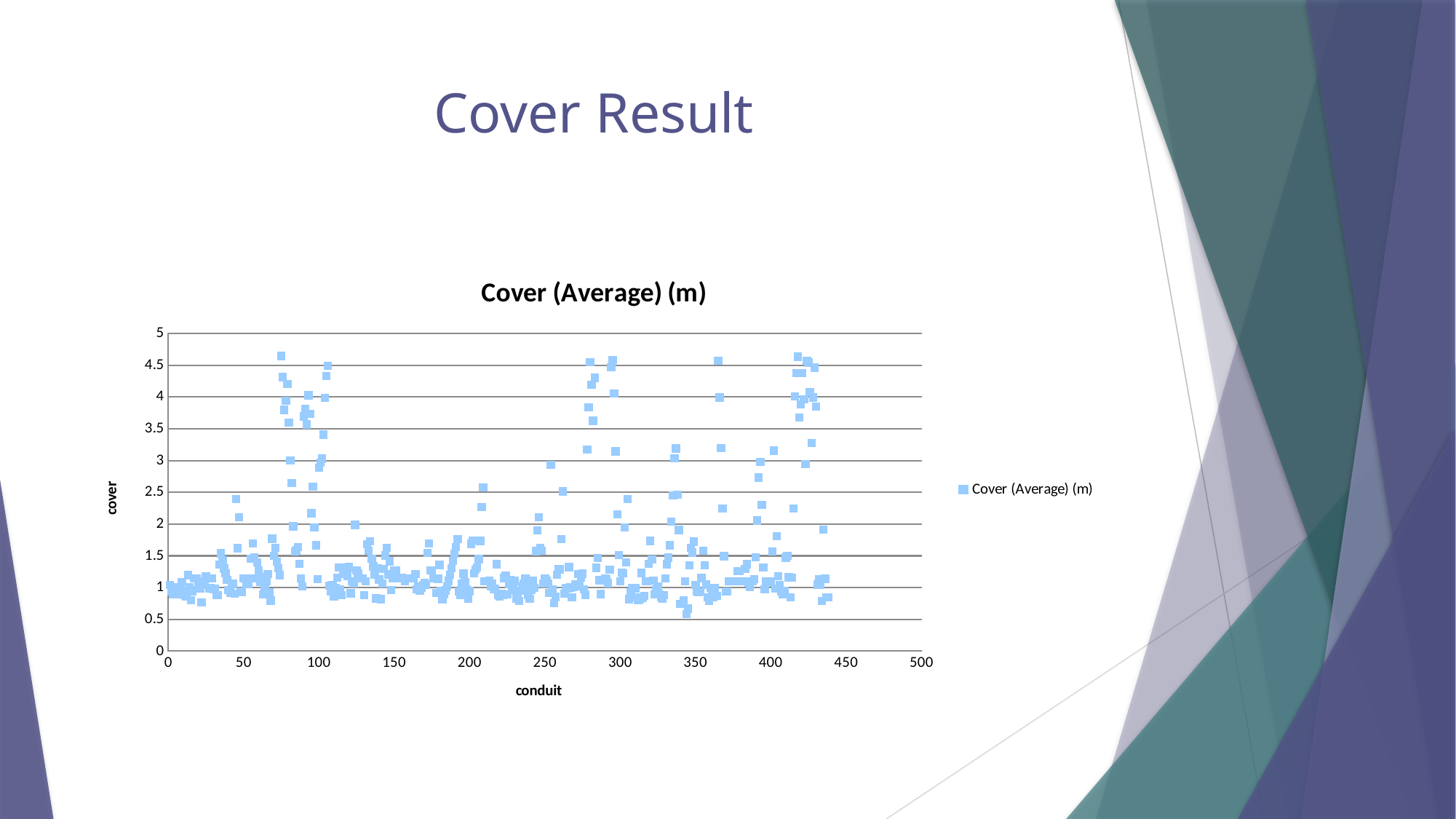
Is the highest plotted cover value greater or less than 5? less What kind of chart is shown on the slide? scatter chart What is the label of the x axis? conduit What is the highest tick value shown on the y axis? 5 Do the plotted points extend beyond a conduit value of 450 on the x axis? No Is the lowest plotted cover value greater or less than 1? less What is the title of the chart? Cover (Average) (m) What is the highest tick value shown on the x axis? 500 How many series does the legend list? 1